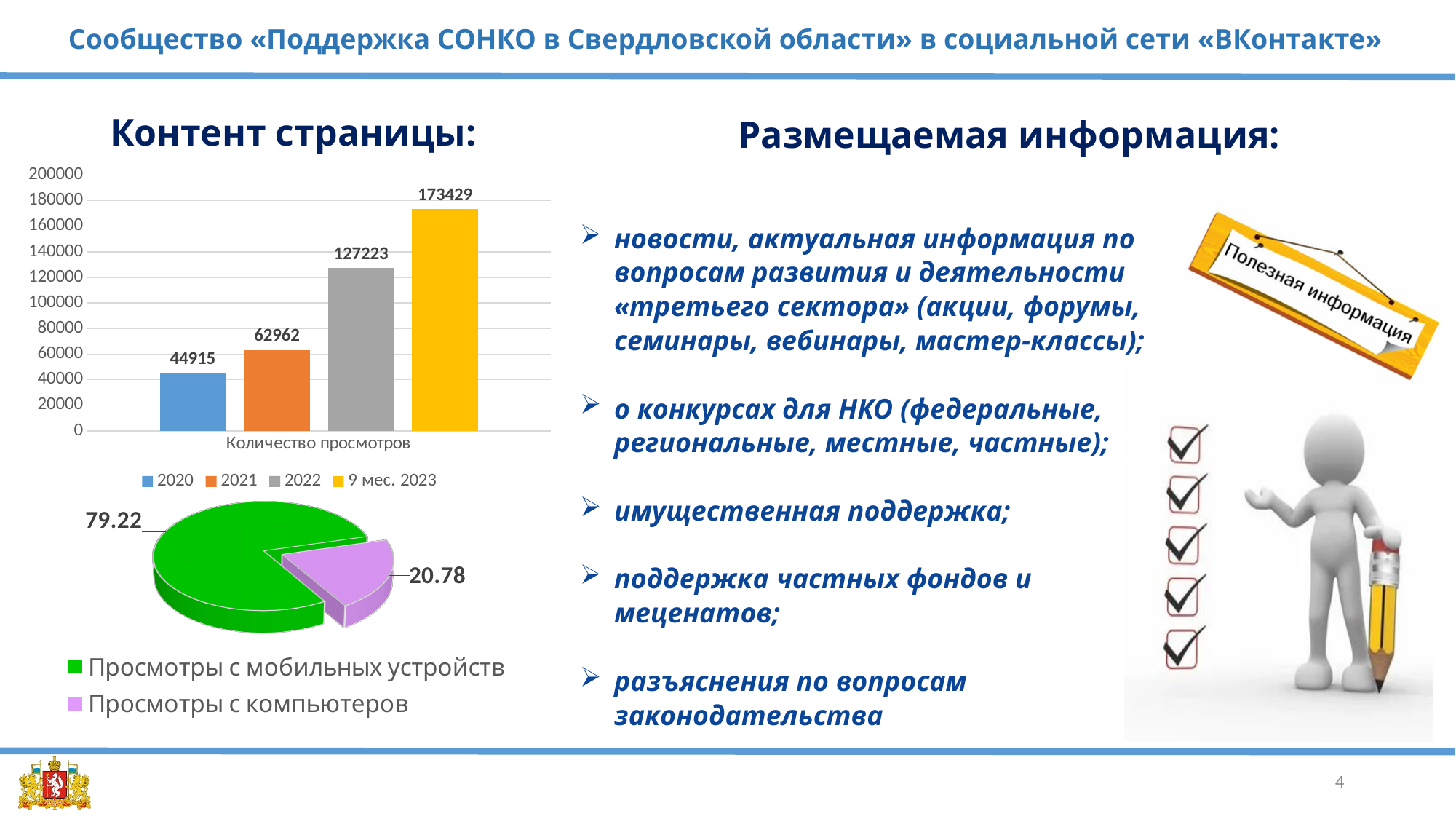
In the bar chart at the top left of the slide, which is larger: the value for 2021 or the value for 2020? 2021 In the bar chart at the top left of the slide, do the values rise or fall from 2020 to 9 мес. 2023? rise In the pie chart at the bottom left of the slide, what is the value for Просмотры с компьютеров? 20.78 In the bar chart at the top left of the slide, what is the value for 2020? 44915 In the bar chart at the top left of the slide, which series has the highest value? 9 мес. 2023 In the bar chart at the top left of the slide, what is the difference between the values for 9 мес. 2023 and 2022? 46206 In the pie chart at the bottom left of the slide, which slice is larger: Просмотры с мобильных устройств or Просмотры с компьютеров? Просмотры с мобильных устройств In the bar chart at the top left of the slide, what is the value for 2022? 127223 In the bar chart at the top left of the slide, how many series does the legend list? 4 In the pie chart at the bottom left of the slide, what colour is the slice for Просмотры с мобильных устройств? green What kind of chart is the chart at the top left of the slide? bar chart In the bar chart at the top left of the slide, which series has the lowest value? 2020